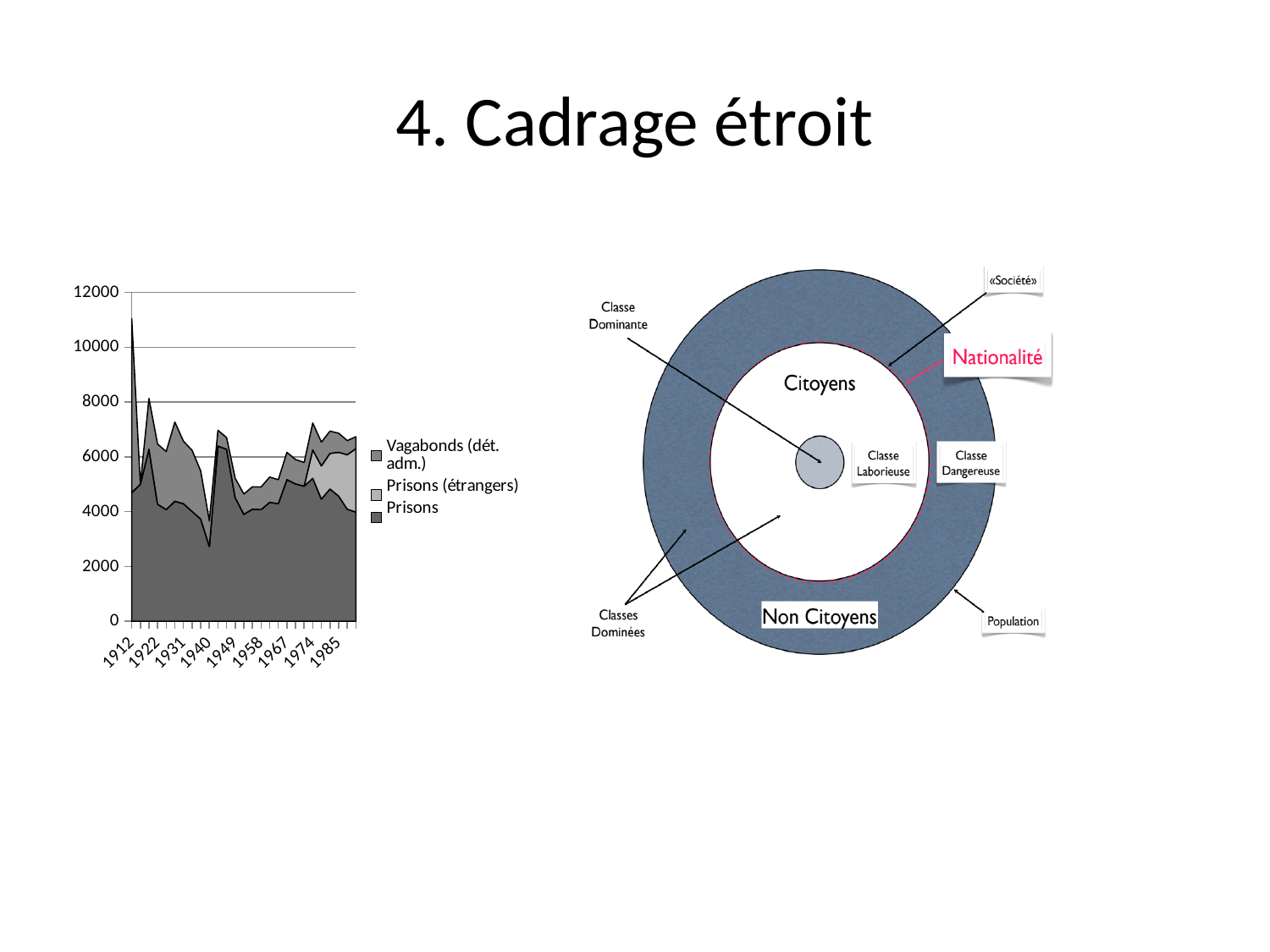
How many year labels are shown on the x axis of the left chart? 9 How many series does the legend of the left chart list? 3 In the left chart, is the stacked total at 1985 greater or less than 8000? less In the left chart, does the stacked total rise or fall between 1912 and 1940? fall In the left chart, which series forms the bottom layer of the stack? Prisons In the left chart, is the stacked total at 1912 greater or less than 10000? greater What kind of chart is shown on the left of the slide? Stacked area chart What is the first year label on the x axis of the left chart? 1912 What is the last year label on the x axis of the left chart? 1985 In the left chart, is the lowest point of the stacked total, around 1940, greater or less than 4000? less What is the highest value shown on the y axis of the left chart? 12000 What are the three series named in the legend of the left chart? Vagabonds (dét. adm.), Prisons (étrangers), Prisons